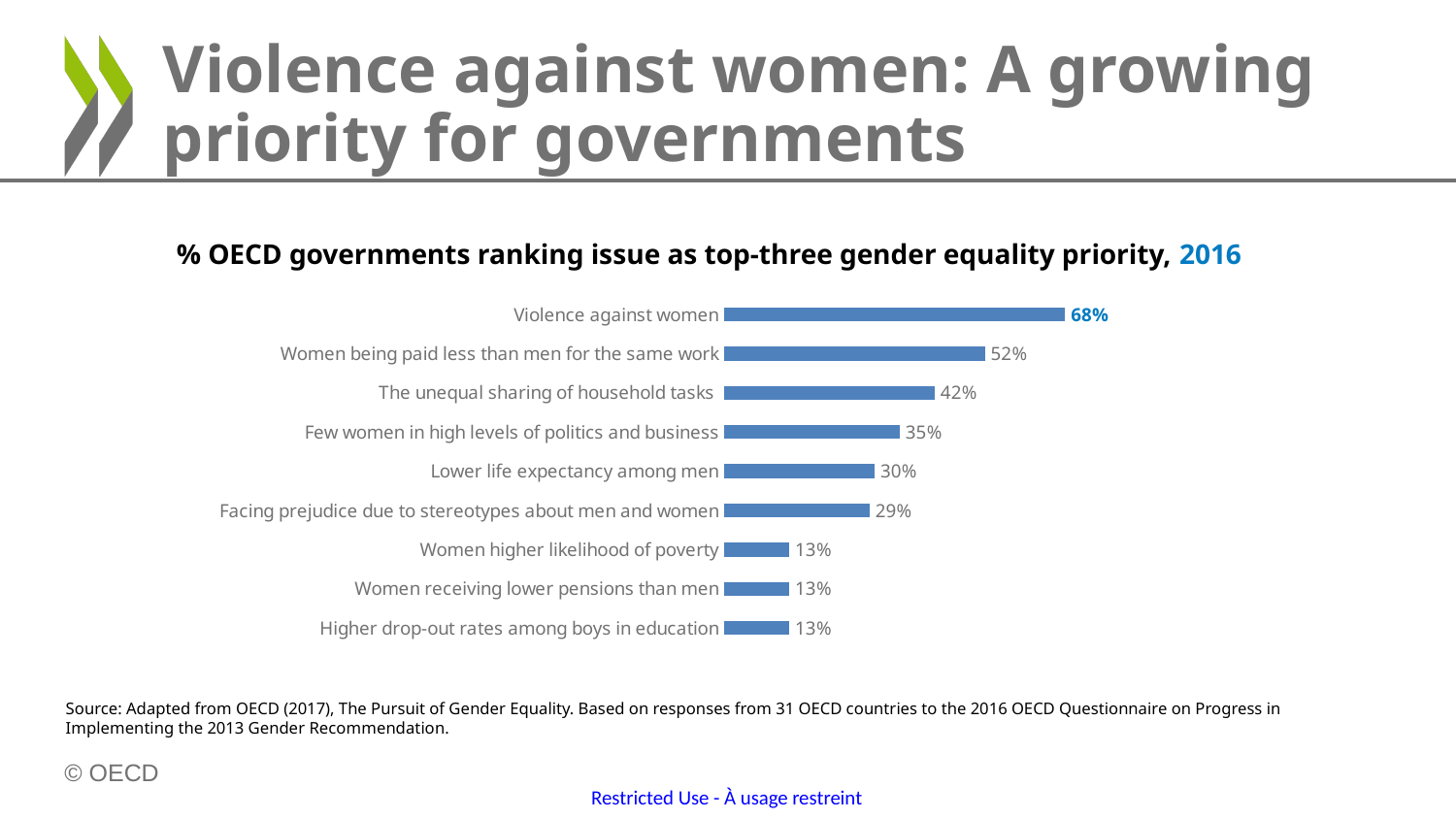
How many issues have a value of 13%? 3 Which issue has the highest percentage of governments ranking it as a top-three priority? Violence against women What year does the chart title refer to? 2016 What is the value for 'Lower life expectancy among men'? 30% What type of chart is shown on the slide? Bar chart What is the value for 'Women being paid less than men for the same work'? 52% What is the value for 'Higher drop-out rates among boys in education'? 13% How many issues are shown in the chart? 9 What percentage of OECD governments ranked violence against women as a top-three gender equality priority? 68% What is the difference between the values for 'Violence against women' and 'Women being paid less than men for the same work'? 16% What is the difference between 'The unequal sharing of household tasks' and 'Few women in high levels of politics and business'? 7% Which is larger: the value for 'Lower life expectancy among men' or 'Facing prejudice due to stereotypes about men and women'? Lower life expectancy among men